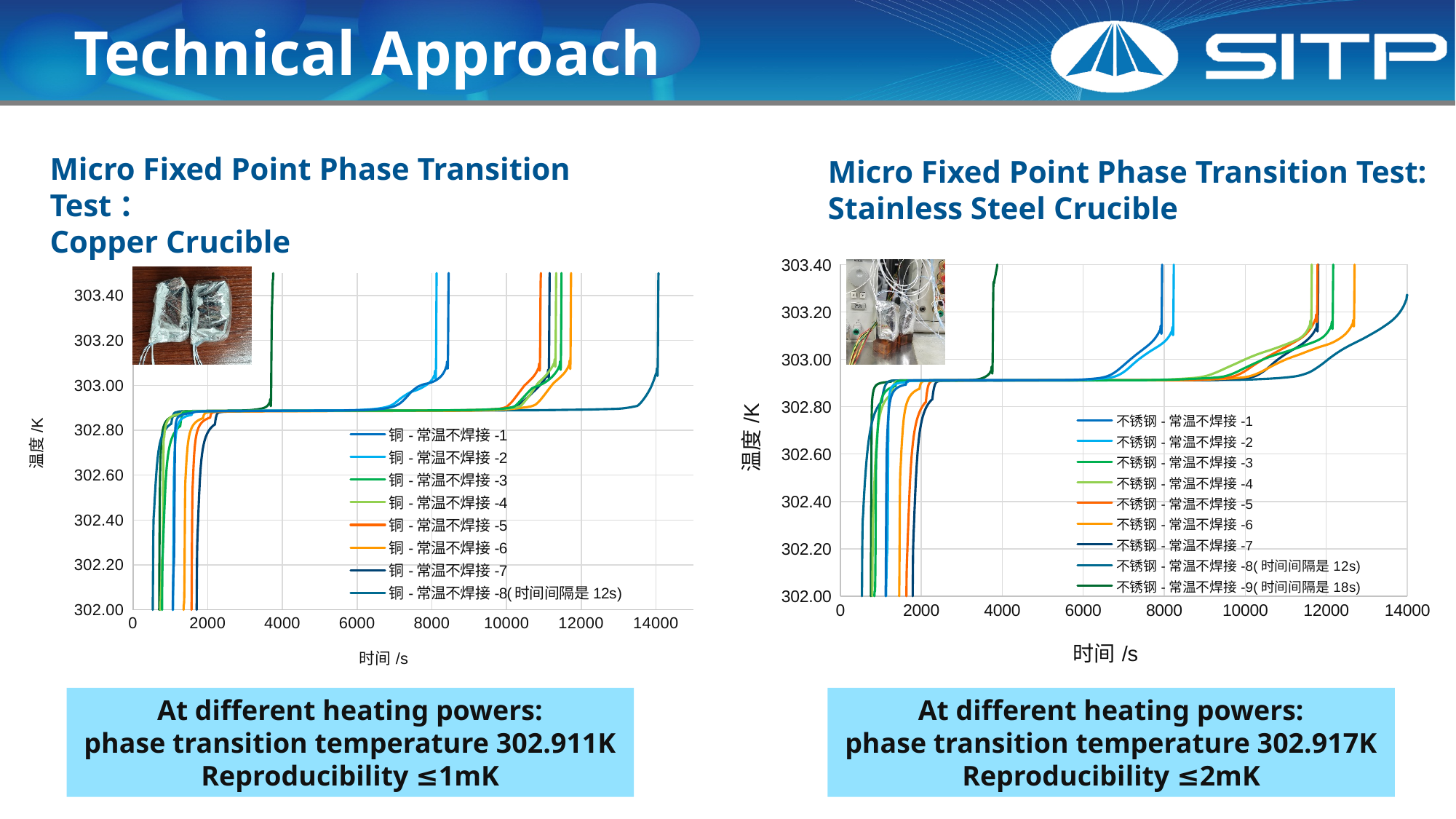
On the Copper Crucible chart on the left, what is the label of the x axis? 时间 /s How many series does the legend of the Stainless Steel Crucible chart on the right list? 9 How many series does the legend of the Copper Crucible chart on the left list? 8 On the Stainless Steel Crucible chart on the right, do the temperature curves generally rise or fall as time increases? rise On the Copper Crucible chart on the left, is the temperature at which the curves start (at the bottom of the chart) greater or less than 302.20? less On the Stainless Steel Crucible chart on the right, is the temperature of the flat plateau section of the curves greater or less than 302.80? greater On the Copper Crucible chart on the left, is the temperature of the flat plateau section of the curves greater or less than 303.00? less What kind of chart is the Stainless Steel Crucible chart on the right? line chart On the Stainless Steel Crucible chart on the right, what is the highest value shown on the x axis? 14000 What kind of chart is the Copper Crucible chart on the left? line chart On the Stainless Steel Crucible chart on the right, what is the label of the y axis? 温度 /K On the Copper Crucible chart on the left, do the temperature curves generally rise or fall as time increases? rise